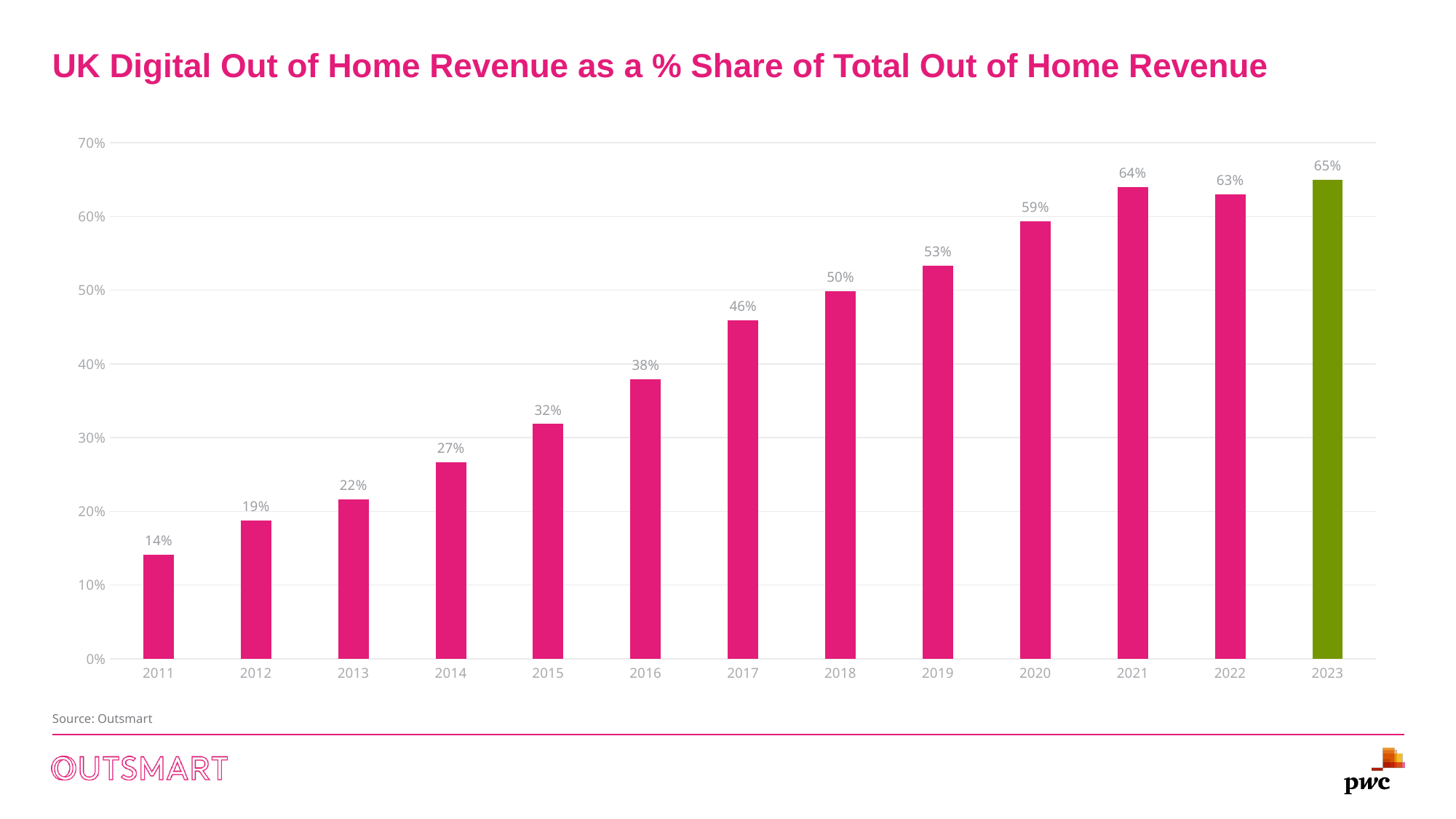
Which year has the lowest digital share of out of home revenue? 2011 How many years are shown on the x axis? 13 What kind of chart is shown on the slide? Bar chart What is the digital share of total out of home revenue in 2011? 14% What is the difference in percentage points between the 2021 and 2022 values? 1 Do the values generally rise or fall from 2011 to 2023? Rise What is the difference in percentage points between the 2023 and 2011 values? 51 What is the digital share of total out of home revenue in 2018? 50% Which year has a larger value, 2016 or 2017? 2017 Which year has the highest digital share of out of home revenue? 2023 Which year's bar is coloured green instead of pink? 2023 What is the digital share of total out of home revenue in 2023? 65%